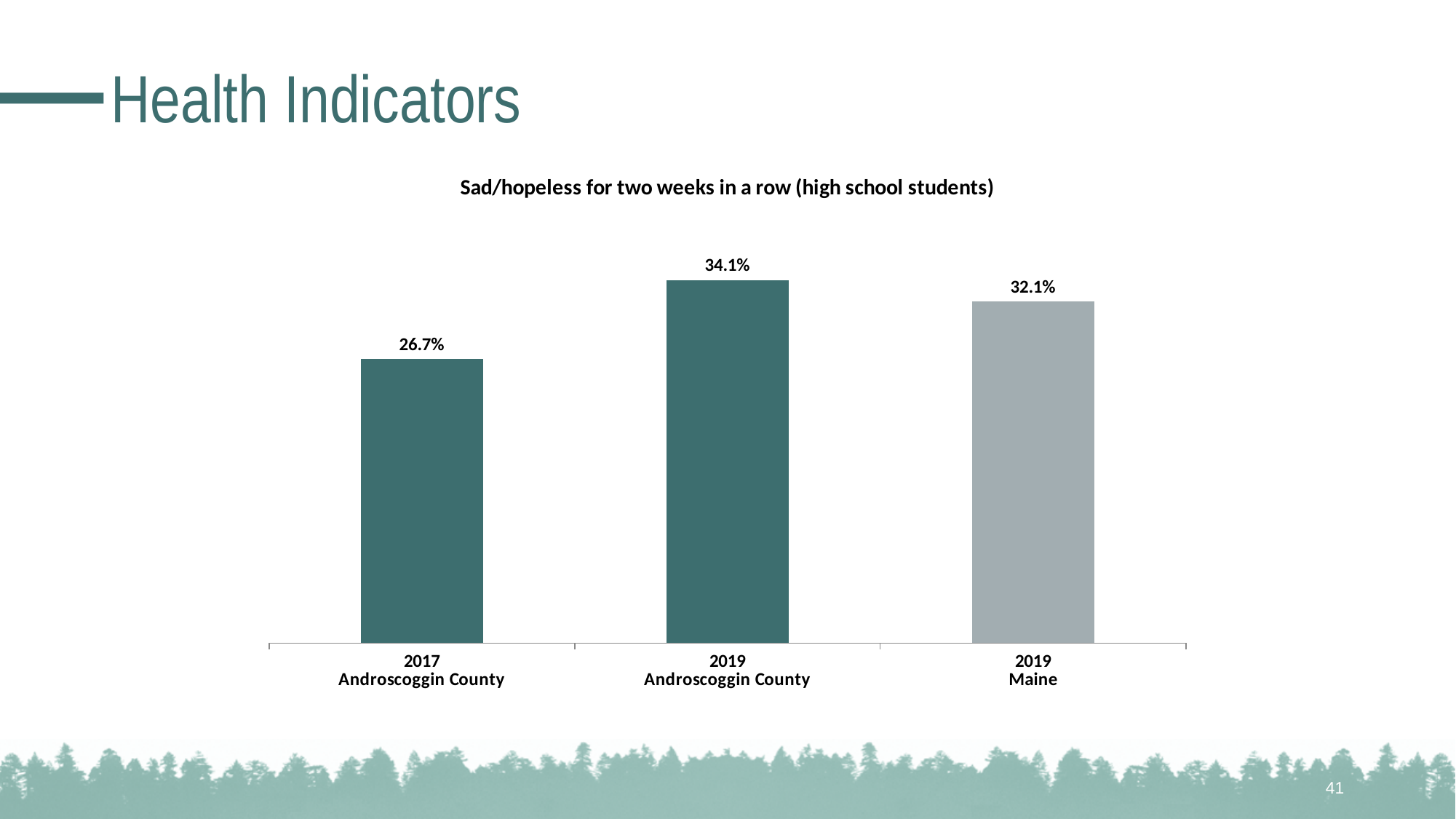
Which category has the lowest value? 2017 Androscoggin County What is the value for 2019 Androscoggin County? 34.1% Which category has the highest value? 2019 Androscoggin County Did the Androscoggin County value rise or fall from 2017 to 2019? Rise What is the difference between the 2019 Androscoggin County value and the 2019 Maine value? 2.0% Which is larger, the value for 2019 Androscoggin County or the value for 2019 Maine? 2019 Androscoggin County What is the value for 2017 Androscoggin County? 26.7% What kind of chart is shown on the slide? Bar chart What is the value for 2019 Maine? 32.1% How many bars are shown in the chart? 3 What is the difference between the 2019 Androscoggin County value and the 2017 Androscoggin County value? 7.4% What is the title of the chart? Sad/hopeless for two weeks in a row (high school students)